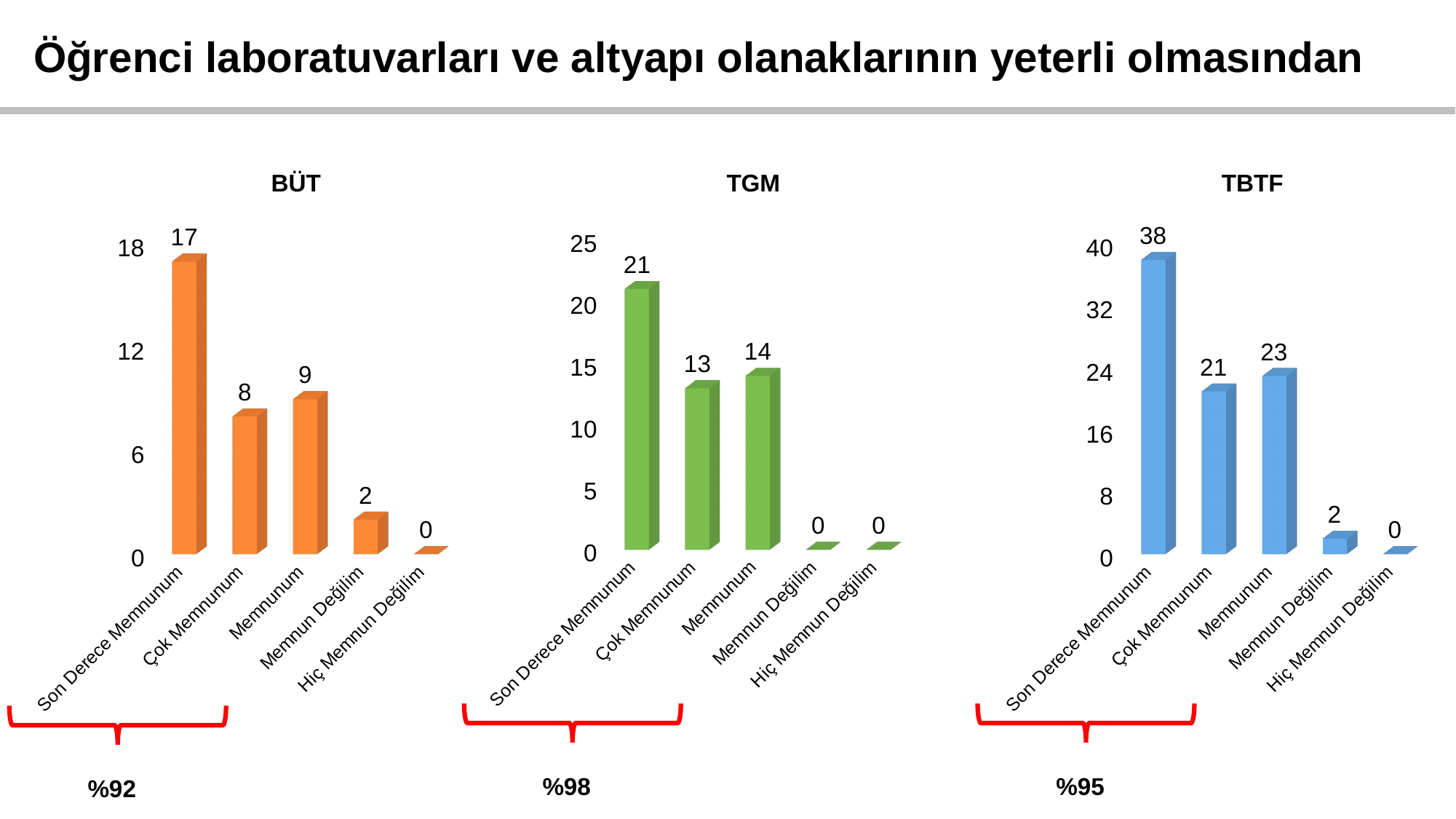
How many categories does the TGM chart show? 5 What colour are the bars in the TGM chart? green In the TGM chart, what is the value for Memnunum? 14 In the TBTF chart, which category has the highest value? Son Derece Memnunum In the BÜT chart, which is larger, Çok Memnunum or Memnunum? Memnunum In the BÜT chart, which category has the lowest value? Hiç Memnun Değilim In the TBTF chart, what is the value for Çok Memnunum? 21 In the TGM chart, is the value for Son Derece Memnunum greater or less than 20? greater In the TBTF chart, what is the difference between Son Derece Memnunum and Memnunum? 15 In the BÜT chart, what is the value for Son Derece Memnunum? 17 What kind of chart is the BÜT chart? bar chart In the TGM chart, what is the difference between Son Derece Memnunum and Çok Memnunum? 8